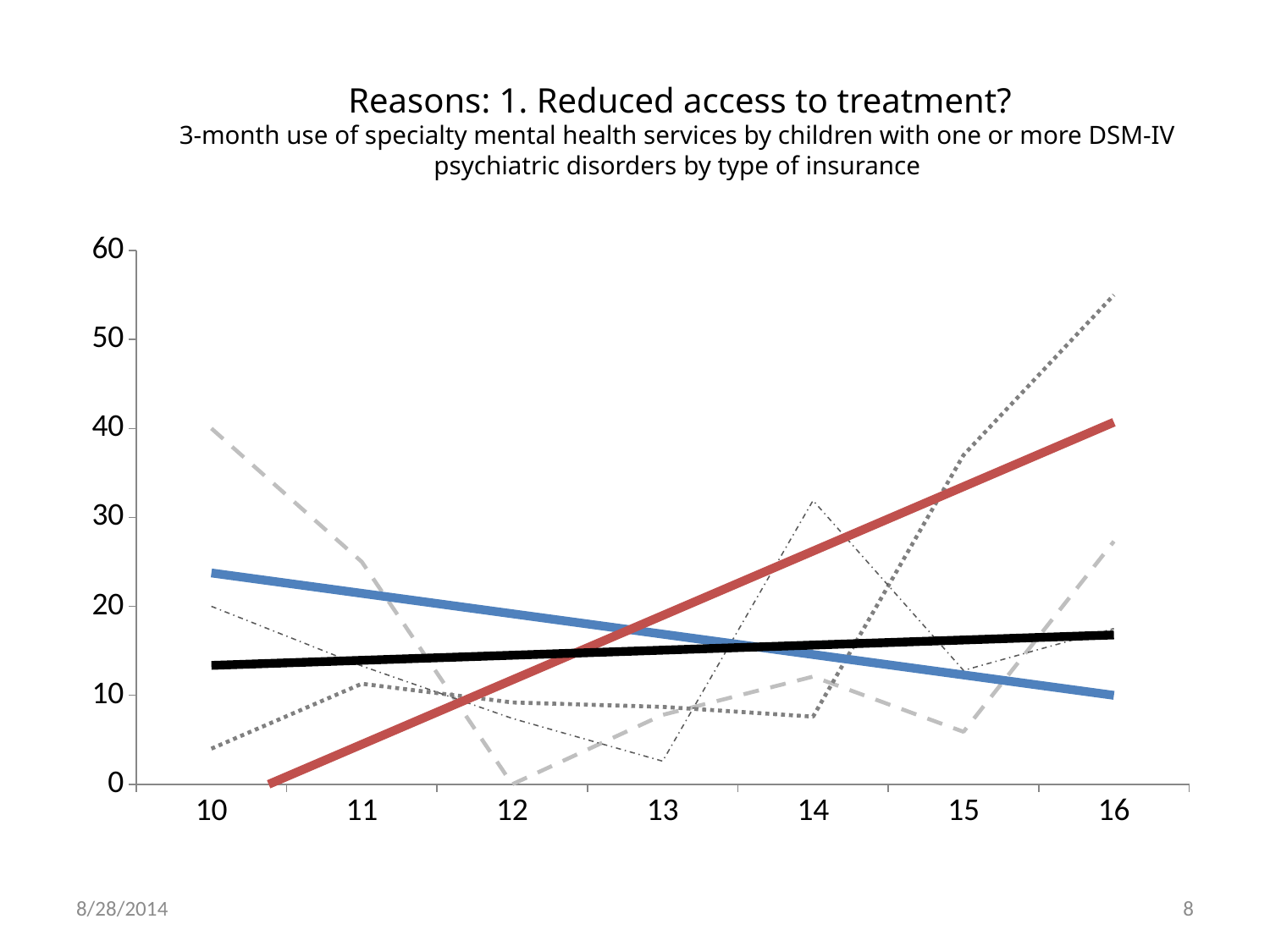
Is the value of the grey dashed line at x = 12 greater or less than 10? less Is the value of the grey dotted line at x = 16 greater or less than 50? greater What is the highest value shown on the y-axis? 60 At x = 10, which line is higher: the thick blue line or the thick black line? the thick blue line At x = 16, which line is higher: the thick red line or the thick blue line? the thick red line Which line has the highest value at x = 16? the grey dotted line How many x-axis values (ages) are labelled on the chart? 7 What kind of chart is shown on the slide? line chart Does the thick red line rise or fall as the x-axis goes from 10 to 16? rise Is the value of the thick blue line at x = 10 greater or less than 20? greater Does the thick blue line rise or fall as the x-axis goes from 10 to 16? fall